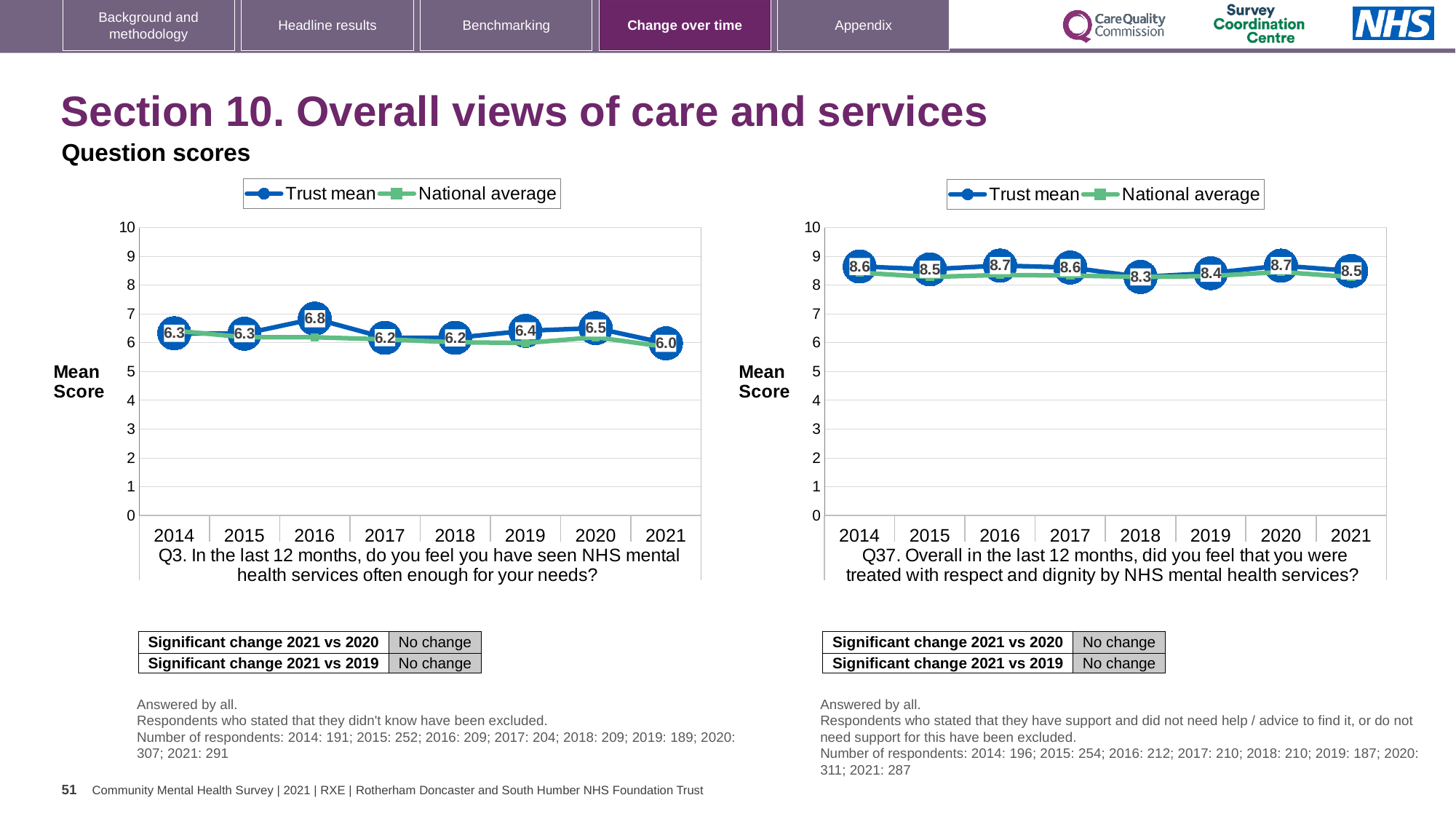
In the right chart (Q37), is the Trust mean score for 2020 larger or smaller than for 2018? larger In the right chart (Q37), what is the Trust mean score for 2020? 8.7 How many years are plotted on the x axis of the left chart (Q3)? 8 In the left chart (Q3), what is the Trust mean score for 2021? 6.0 In the left chart (Q3), which year has the lowest Trust mean score? 2021 In the left chart (Q3), what is the difference between the Trust mean scores for 2016 and 2021? 0.8 In the right chart (Q37), is the National average value for 2014 greater or less than 7? greater In the right chart (Q37), what is the Trust mean score for 2018? 8.3 In the left chart (Q3), what is the Trust mean score for 2016? 6.8 In the left chart (Q3), which year has the highest Trust mean score? 2016 How many series does the legend of the right chart (Q37) list? 2 In the right chart (Q37), which year has the lowest Trust mean score? 2018